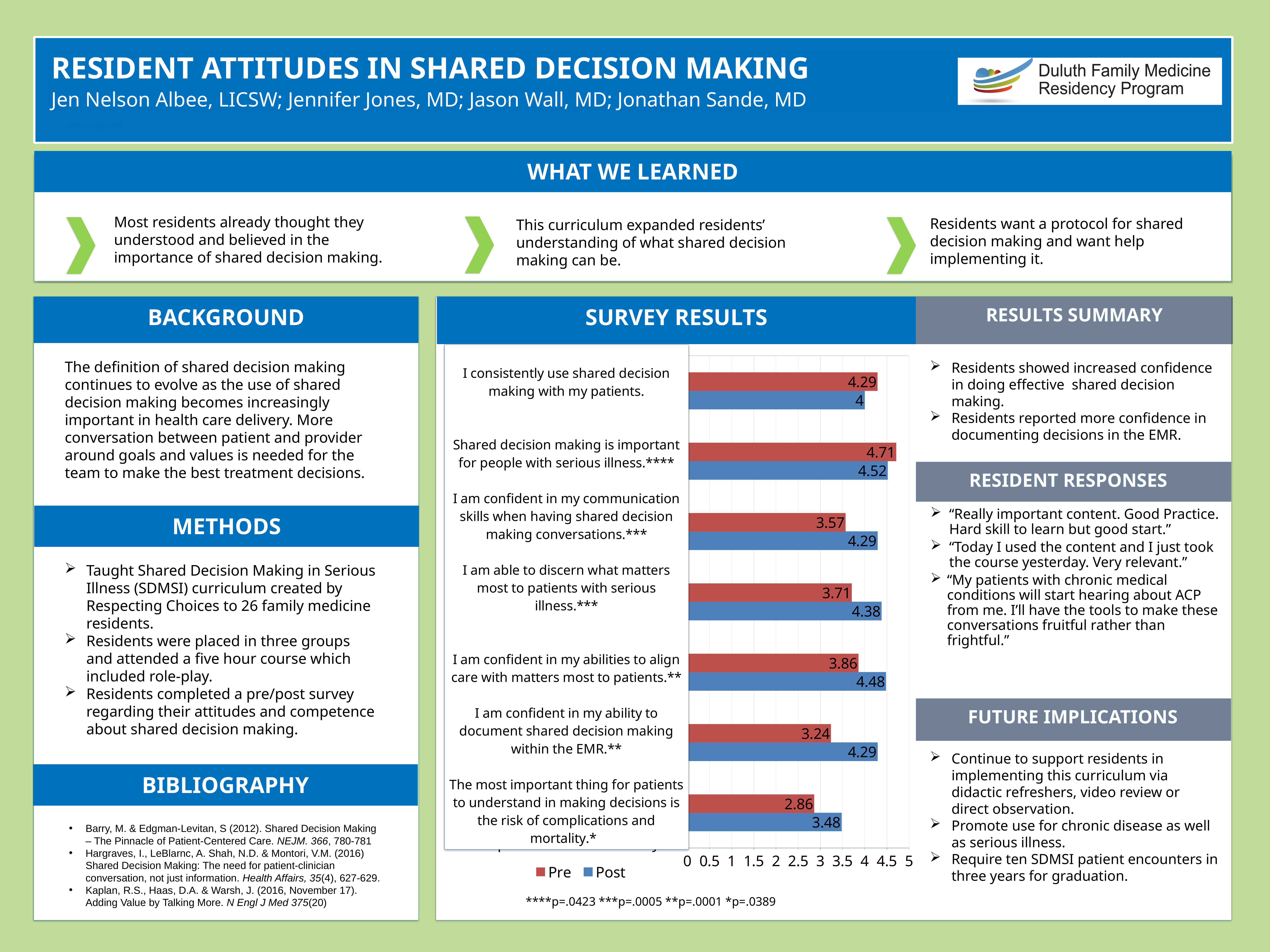
Which statement has the highest Pre value? Shared decision making is important for people with serious illness. Which colour represents the Post series? Blue How many survey statements are shown in the chart? 7 What is the Post value for "Shared decision making is important for people with serious illness"? 4.52 For "I consistently use shared decision making with my patients", which is larger, the Pre or the Post value? Pre Which statement has the lowest Post value? The most important thing for patients to understand in making decisions is the risk of complications and mortality. How many series does the legend list? 2 What is the Post value for "I consistently use shared decision making with my patients"? 4 What is the Pre value for "I am confident in my ability to document shared decision making within the EMR"? 3.24 What is the difference between the Post and Pre values for "I am confident in my ability to document shared decision making within the EMR"? 1.05 What kind of chart is shown in the Survey Results section? Bar chart Is the Pre value for "I am able to discern what matters most to patients with serious illness" greater or less than 4? less